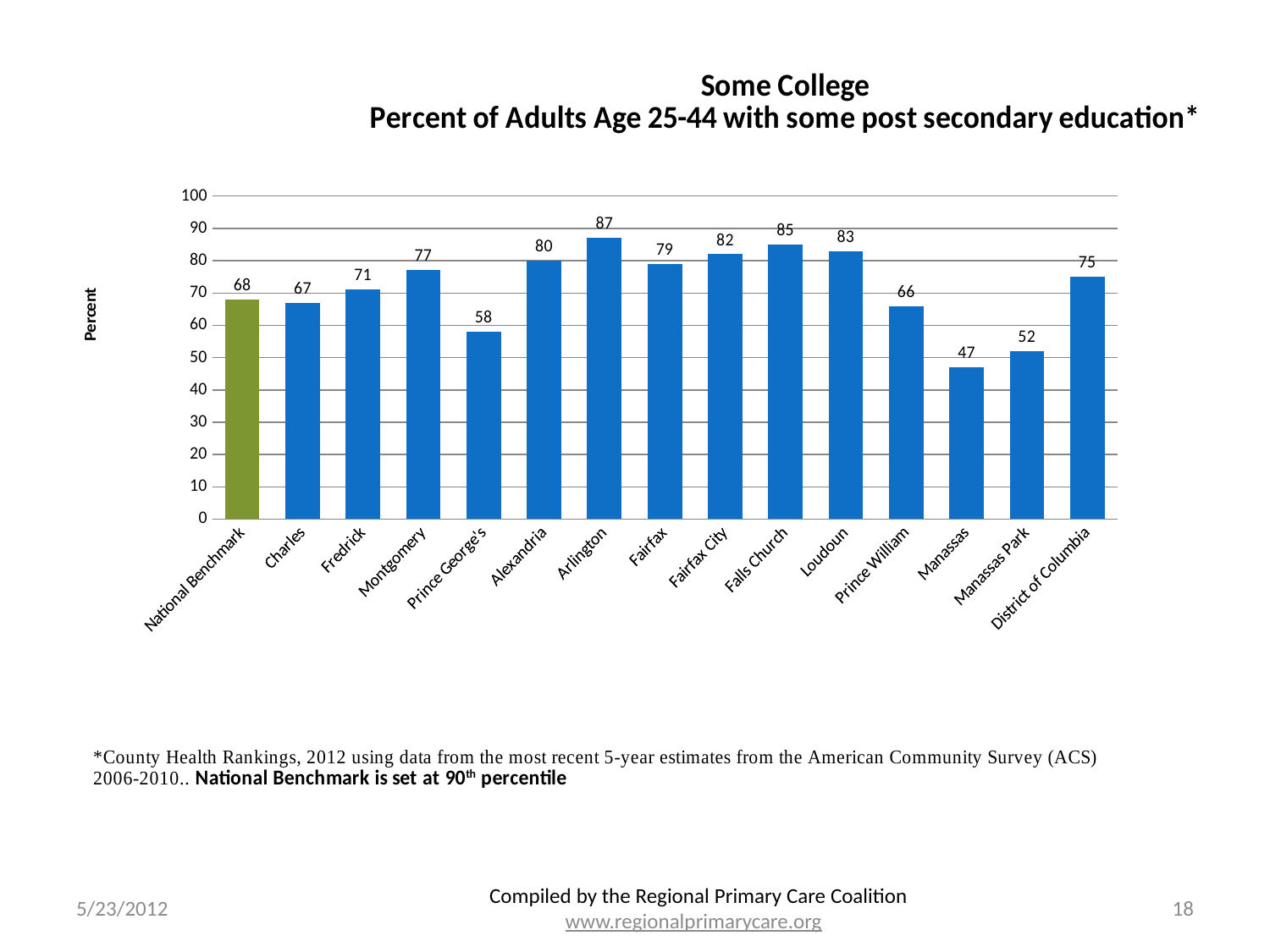
Which bar is shown in a different colour from the others? National Benchmark What is the value for Manassas Park? 52 How many categories are shown on the x axis? 15 What is the value for Arlington? 87 Is the value for Montgomery greater or less than 70? greater What is the value for the National Benchmark? 68 Which is larger, the value for Loudoun or the value for Fairfax City? Loudoun What is the label of the y axis? Percent What is the difference between the values for Falls Church and Prince George's? 27 What kind of chart is shown on the slide? Bar chart Which category has the highest value? Arlington Which category has the lowest value? Manassas